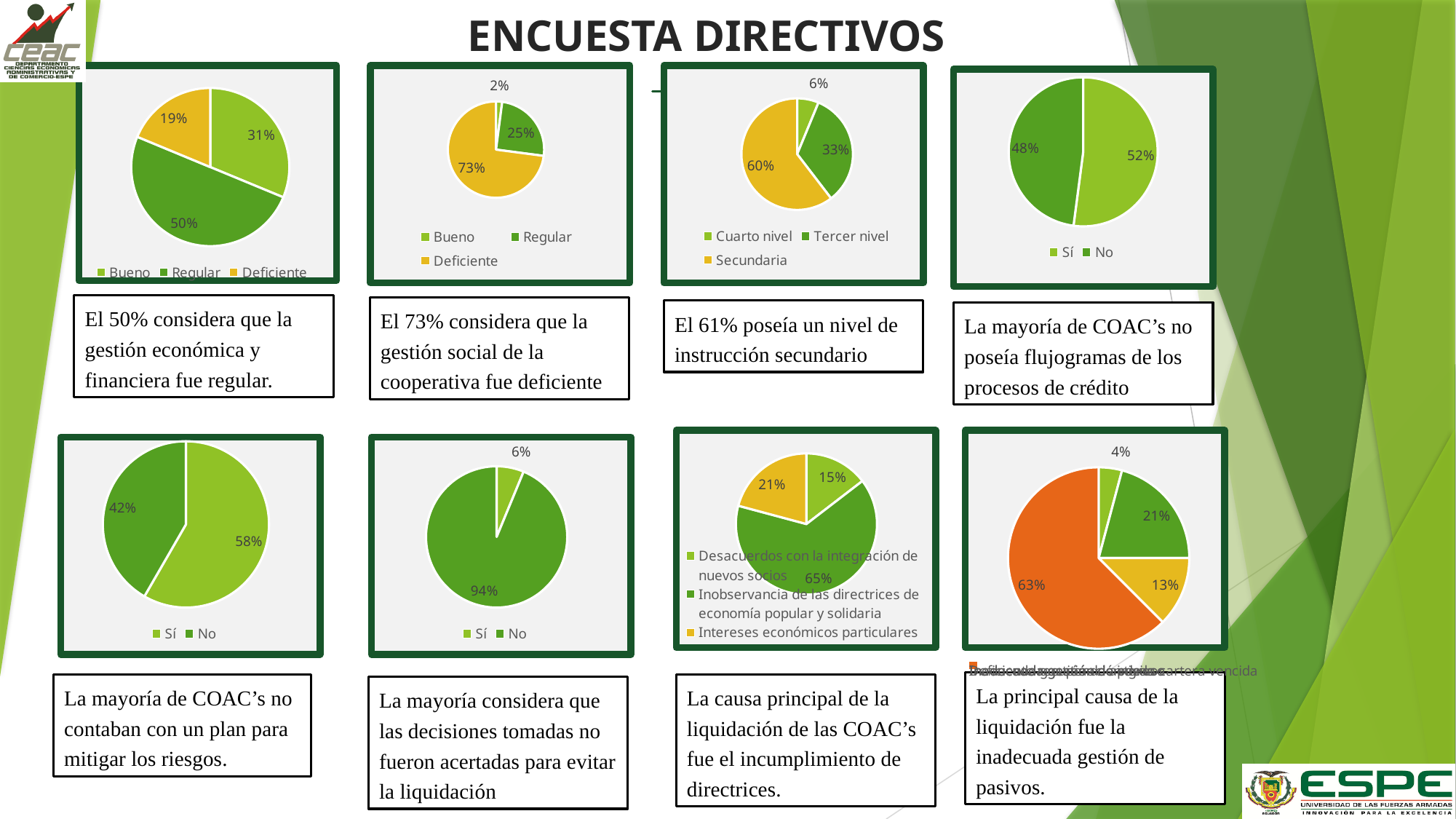
In the third pie chart of the top row (Cuarto nivel/Tercer nivel/Secundaria), which category has the largest share? Secundaria In the second pie chart of the top row, what is the difference between the Deficiente and Regular shares? 48% In the second pie chart of the top row (Bueno/Regular/Deficiente), what percentage is shown for Deficiente? 73% In the top-left pie chart (Bueno/Regular/Deficiente), what percentage is shown for Regular? 50% In the third pie chart of the top row, what percentage is shown for Tercer nivel? 33% What type of chart is used throughout this slide? Pie chart In the second pie chart of the bottom row (Sí/No), what percentage is shown for No? 94% In the third pie chart of the bottom row, what percentage is shown for 'Inobservancia de las directrices de economía popular y solidaria'? 65% In the top-right pie chart (Sí/No), which is larger, Sí or No? Sí How many slices does the bottom-right pie chart have? 4 In the top-left pie chart, which category has the smallest share? Deficiente In the bottom-left pie chart (Sí/No), what percentage is shown for No? 42%